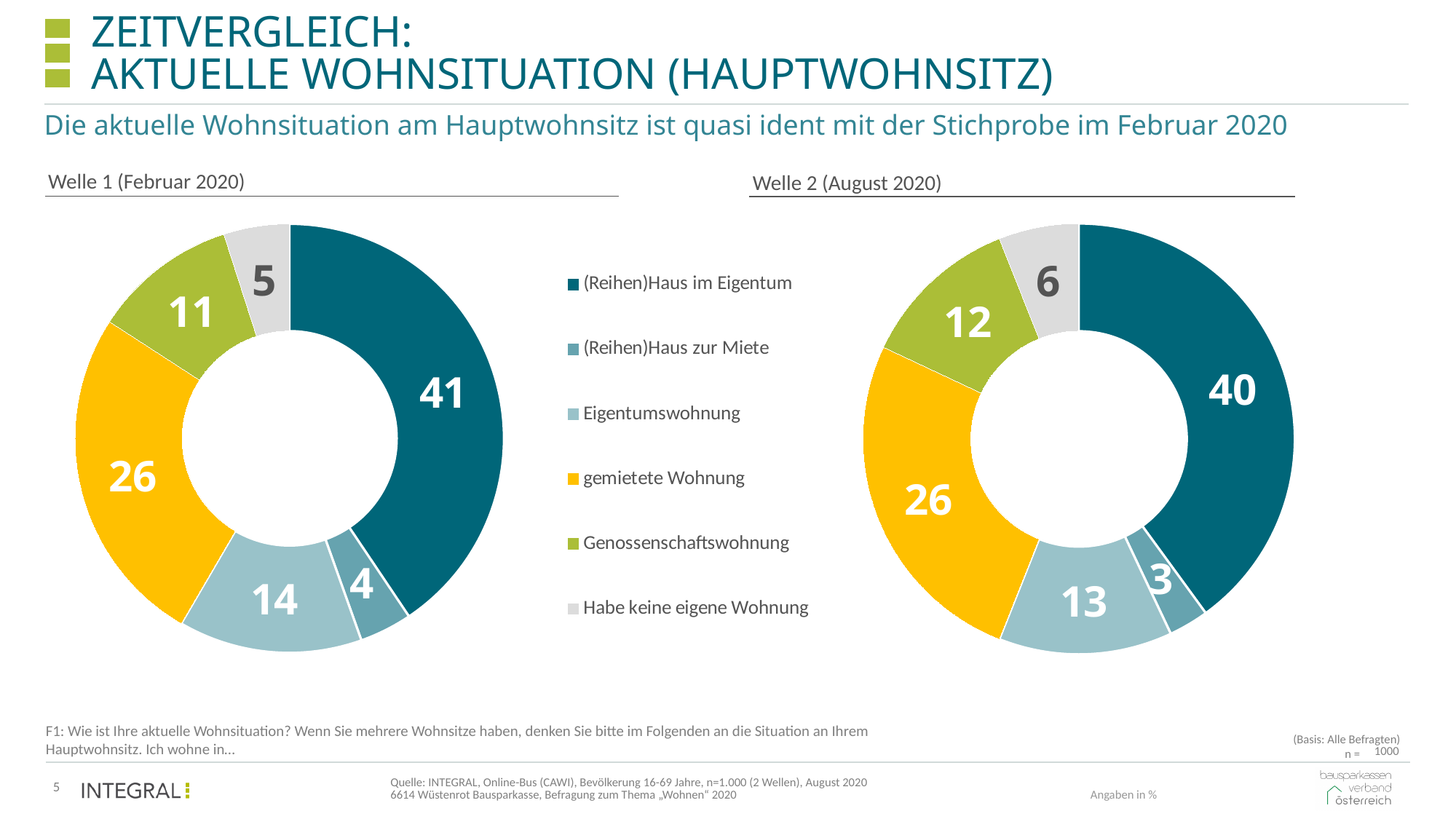
Which colour represents gemietete Wohnung in the legend? Yellow In the Welle 2 (August 2020) chart, what is the value for Habe keine eigene Wohnung? 6 In the Welle 1 (Februar 2020) chart, what is the combined value of (Reihen)Haus im Eigentum and (Reihen)Haus zur Miete? 45 How many categories does the legend list? 6 In the Welle 1 (Februar 2020) chart, what is the value for (Reihen)Haus im Eigentum? 41 Is the value for Genossenschaftswohnung larger in the Welle 1 (Februar 2020) chart or in the Welle 2 (August 2020) chart? Welle 2 (August 2020) In the Welle 2 (August 2020) chart, which category has the smallest share? (Reihen)Haus zur Miete In the Welle 2 (August 2020) chart, which is larger: gemietete Wohnung or Eigentumswohnung? gemietete Wohnung In the Welle 1 (Februar 2020) chart, which category has the largest share? (Reihen)Haus im Eigentum In the Welle 2 (August 2020) chart, what is the value for Eigentumswohnung? 13 In the Welle 1 (Februar 2020) chart, what is the difference between gemietete Wohnung and Eigentumswohnung? 12 What kind of chart is used for Welle 1 (Februar 2020)? Donut (pie) chart